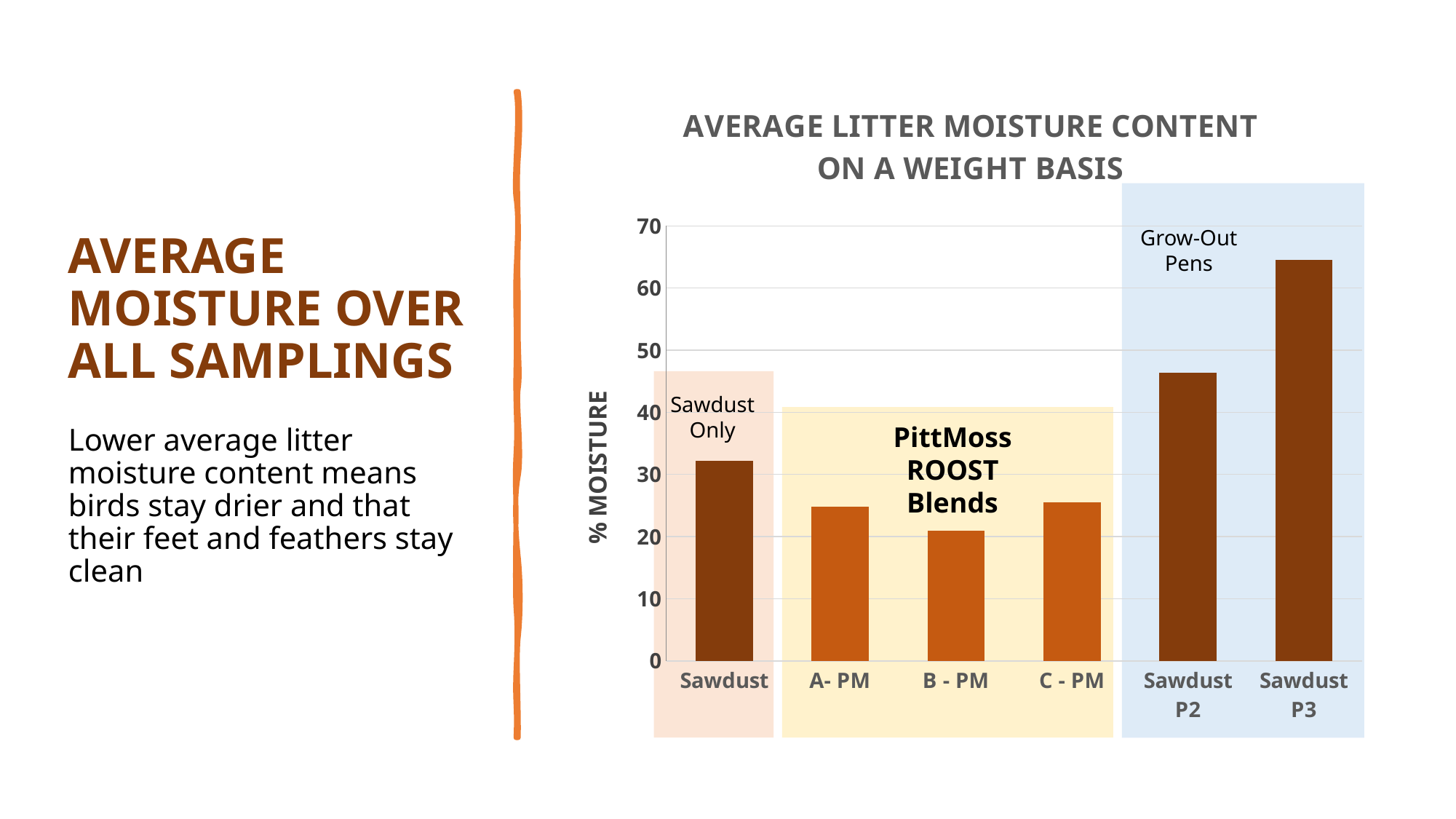
Which category has the highest % moisture? Sawdust P3 What is the label on the vertical axis of the chart? % MOISTURE How many bars (categories) are plotted in the chart? 6 Is the value for B - PM greater or less than 30? less Which has a higher % moisture, Sawdust or B - PM? Sawdust Is the value for Sawdust greater or less than 30? greater Is the value for Sawdust P2 greater or less than 40? greater Which category has the lowest % moisture? B - PM Which has a higher % moisture, Sawdust P2 or Sawdust P3? Sawdust P3 What kind of chart is shown on the slide? bar chart What is the title of the chart? AVERAGE LITTER MOISTURE CONTENT ON A WEIGHT BASIS